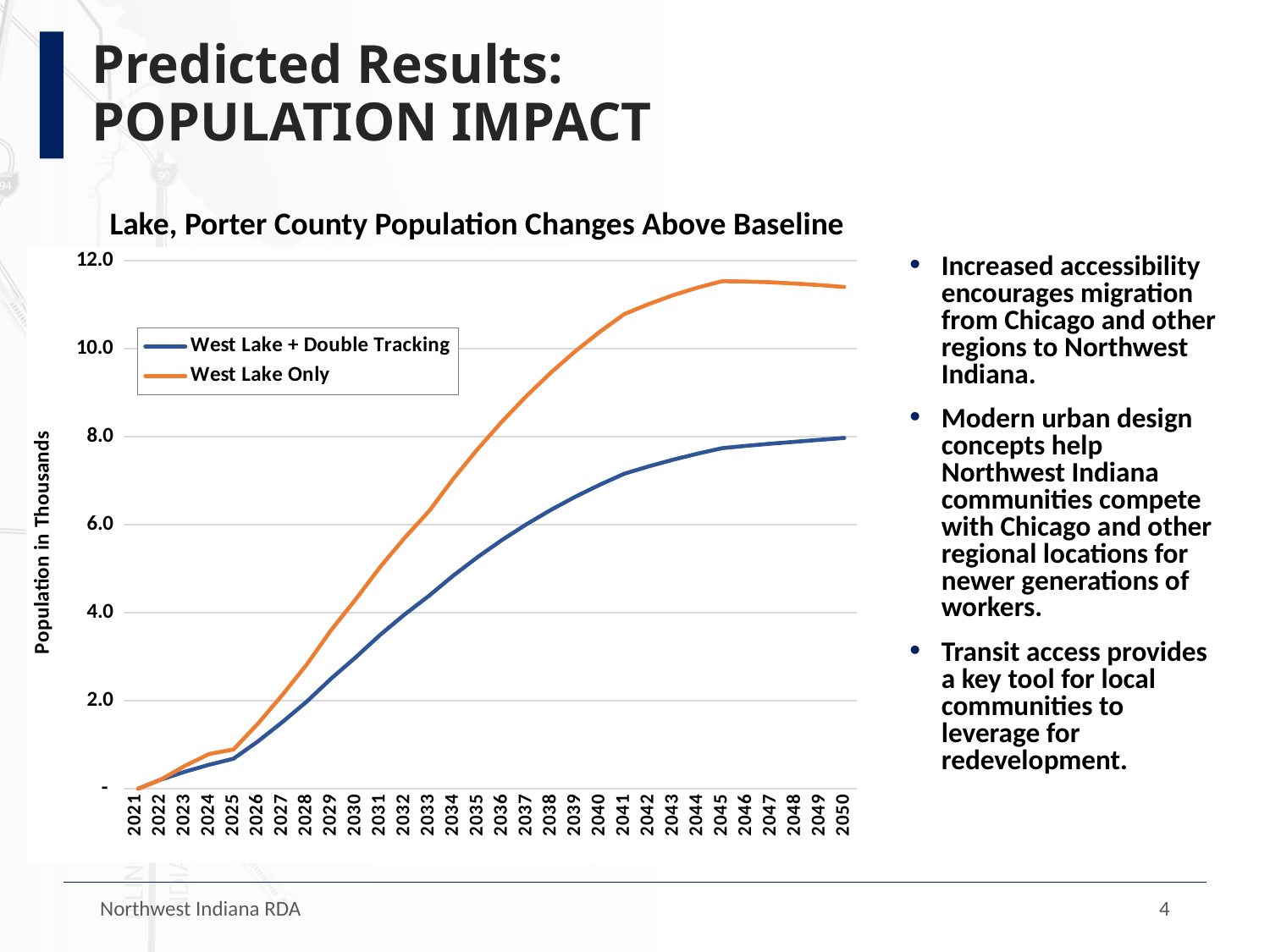
Is the value for West Lake Only in 2050 greater or less than 10.0? greater How many series does the legend list? 2 Is the value for West Lake Only in 2035 greater or less than 6.0? greater What is the label on the y axis of the chart? Population in Thousands Is the value for West Lake + Double Tracking in 2050 greater or less than 10.0? less Which series reaches the higher value by 2050, West Lake + Double Tracking or West Lake Only? West Lake Only What kind of chart is shown on the slide? line chart How many years are plotted along the x axis? 30 What is the title of the chart? Lake, Porter County Population Changes Above Baseline Do the values for West Lake Only generally rise or fall from 2021 to 2045? rise